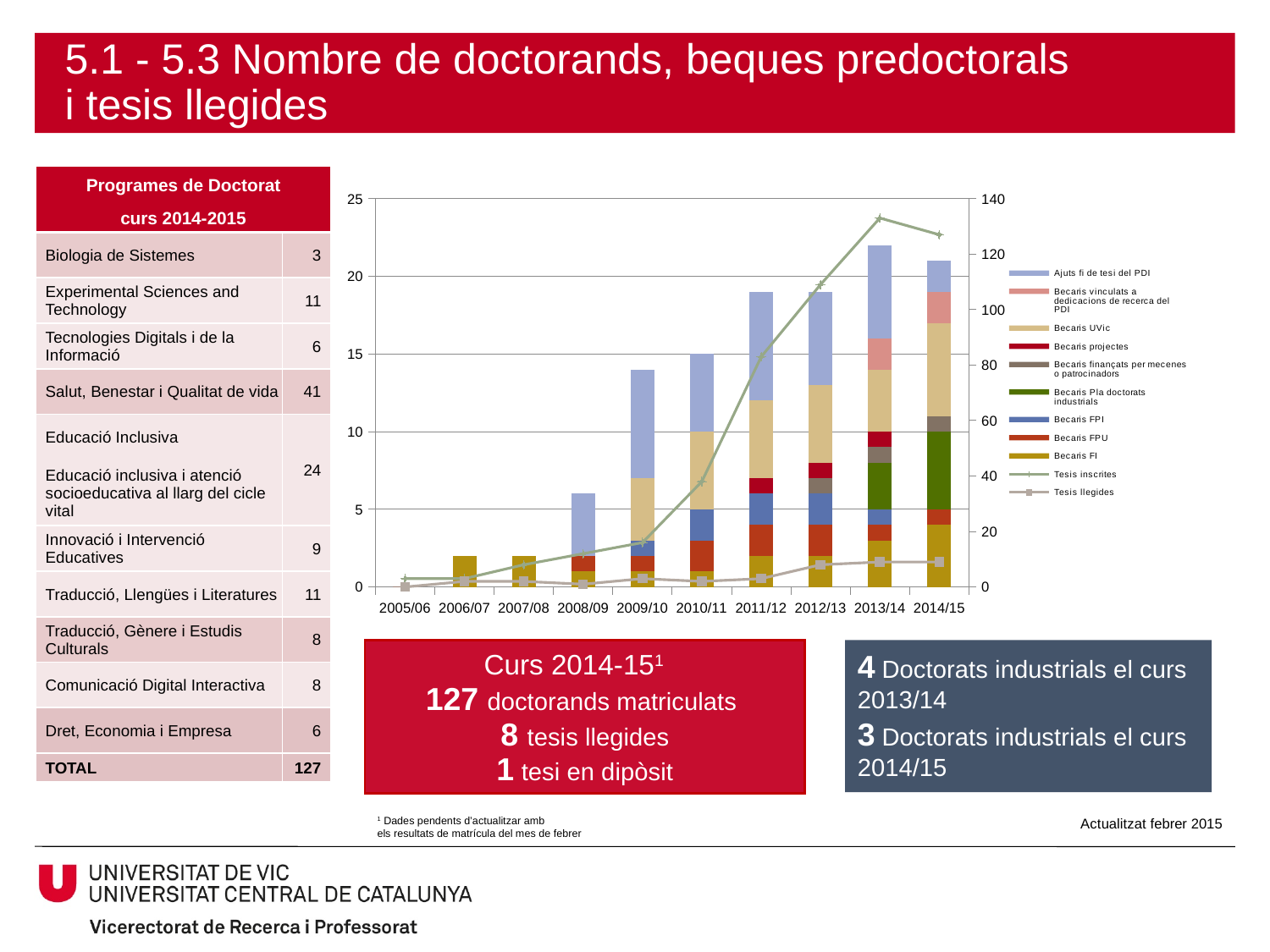
Which legend entry is shown in light blue at the top of the stacked bars? Ajuts fi de tesi del PDI Which academic year has the lowest stacked bar total? 2005/06 Is the value of the Tesis llegides line for 2014/15 greater or less than 20? less How many series does the chart's legend list? 11 Is the value of the Tesis inscrites line for 2013/14 greater or less than 120? greater What kind of chart is used to show the becaris data by academic year? Stacked bar chart with line series How many academic years are shown on the x axis of the chart? 10 Does the Tesis inscrites line rise or fall from 2005/06 to 2013/14? rise Is the value of the Tesis inscrites line for 2005/06 greater or less than 20? less Which stacked bar is taller, 2009/10 or 2006/07? 2009/10